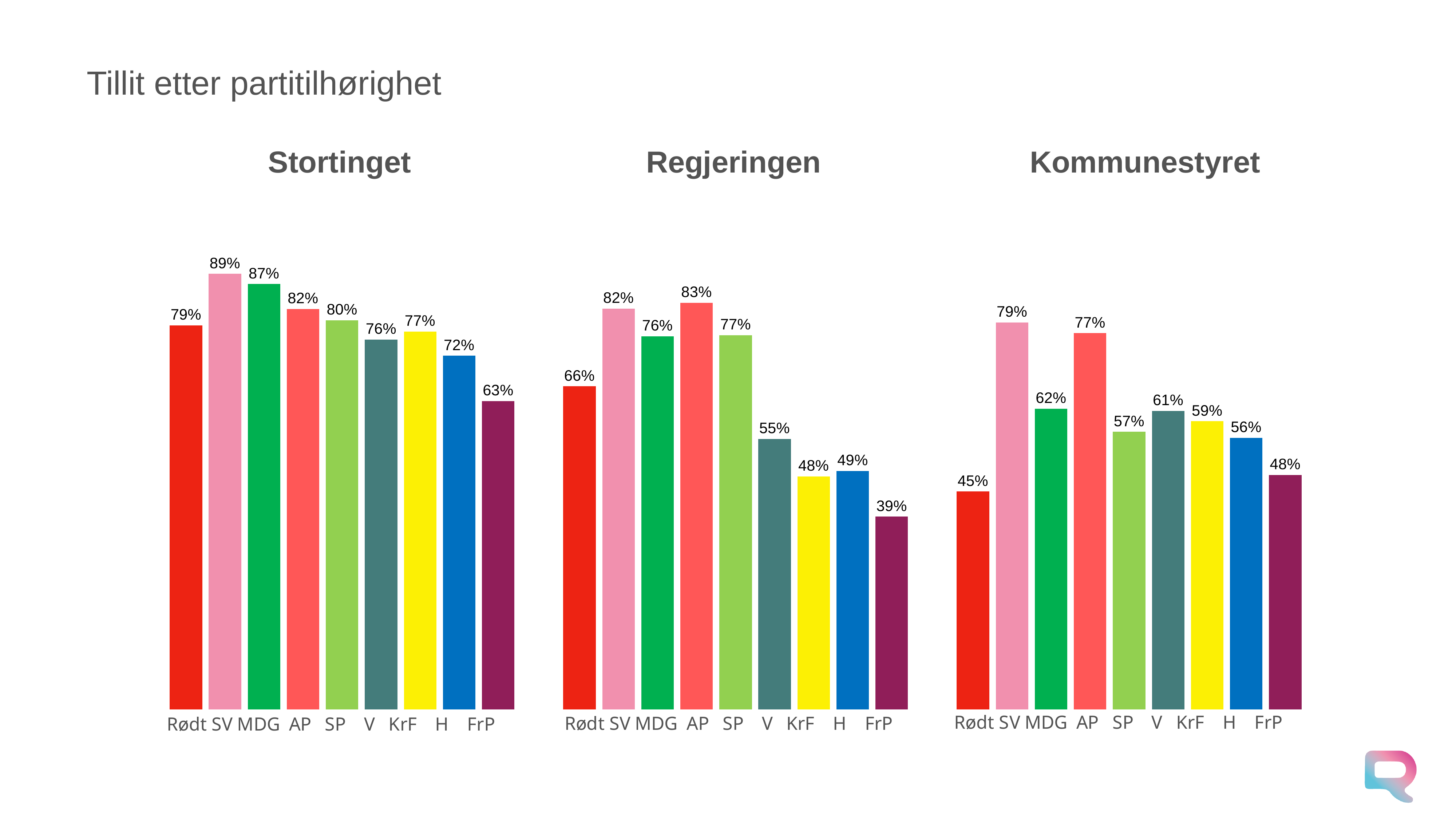
In the Kommunestyret chart, which is larger, the value for SV or the value for AP? SV In the Stortinget chart, what is the value for SV? 89% What is the title of the slide? Tillit etter partitilhørighet What kind of chart is the Regjeringen chart? bar chart In the Kommunestyret chart, what is the value for Rødt? 45% In the Stortinget chart, which party has the lowest value? FrP In the Regjeringen chart, what is the difference between the values for AP and V? 28% In the Regjeringen chart, what is the value for FrP? 39% In the Kommunestyret chart, which party has the lowest value? Rødt In the Kommunestyret chart, what is the difference between the values for MDG and H? 6% In the Regjeringen chart, which party has the highest value? AP In the Stortinget chart, how many parties are shown? 9